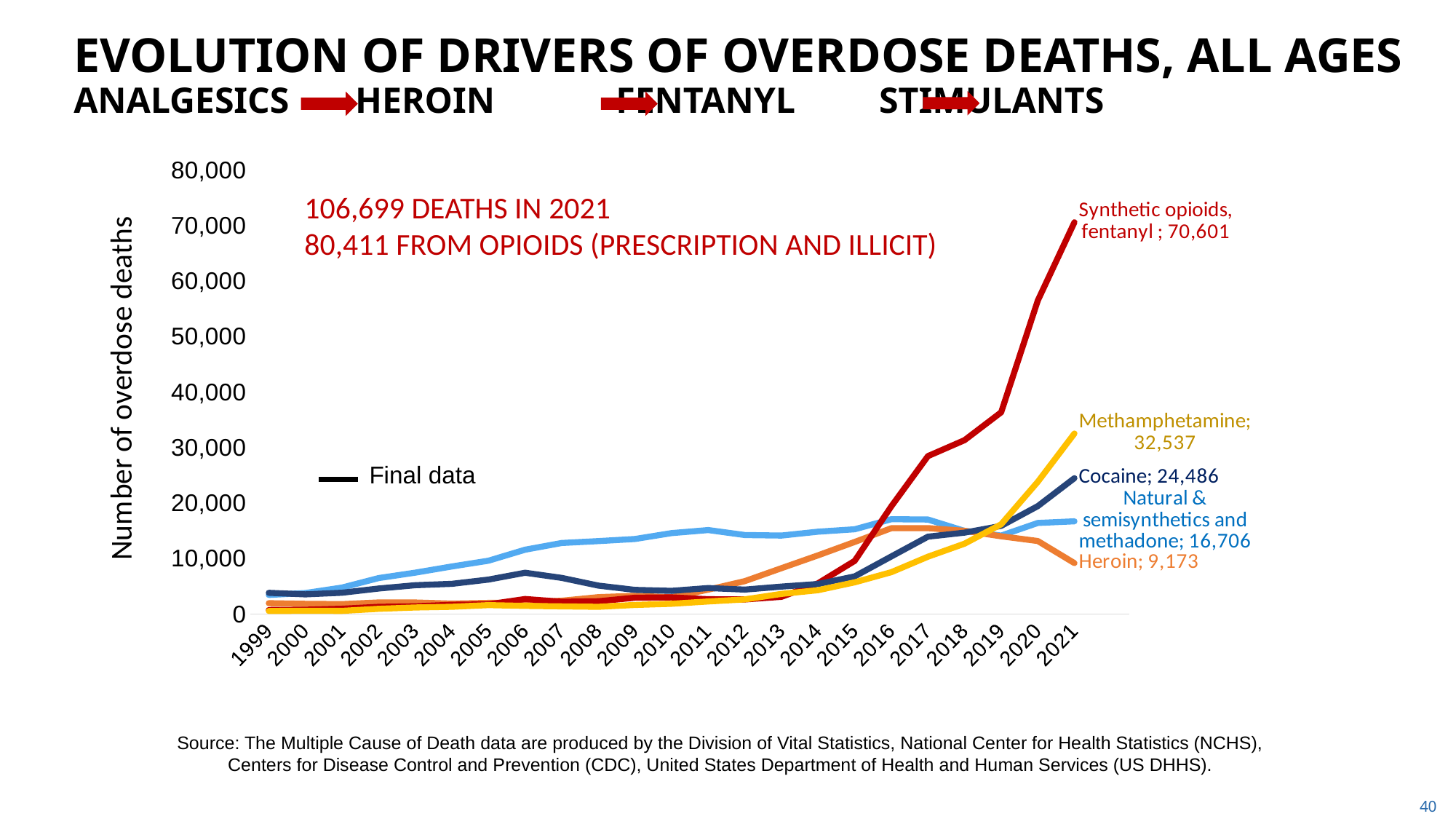
In 2021, which has more overdose deaths: methamphetamine or cocaine? Methamphetamine What is the difference between synthetic opioid (fentanyl) deaths and methamphetamine deaths in 2021? 38,064 What is the number of overdose deaths from methamphetamine in 2021? 32,537 How many years are shown on the x axis? 23 What is the number of overdose deaths from synthetic opioids (fentanyl) in 2021? 70,601 What is the label of the y axis? Number of overdose deaths Is the number of heroin overdose deaths in 2016 greater or less than 10,000? greater Which drug category has the highest number of overdose deaths in 2021? Synthetic opioids, fentanyl What is the number of overdose deaths from cocaine in 2021? 24,486 What type of chart is shown on the slide? line chart Which labelled drug category has the lowest number of overdose deaths in 2021? Heroin What is the number of overdose deaths from heroin in 2021? 9,173